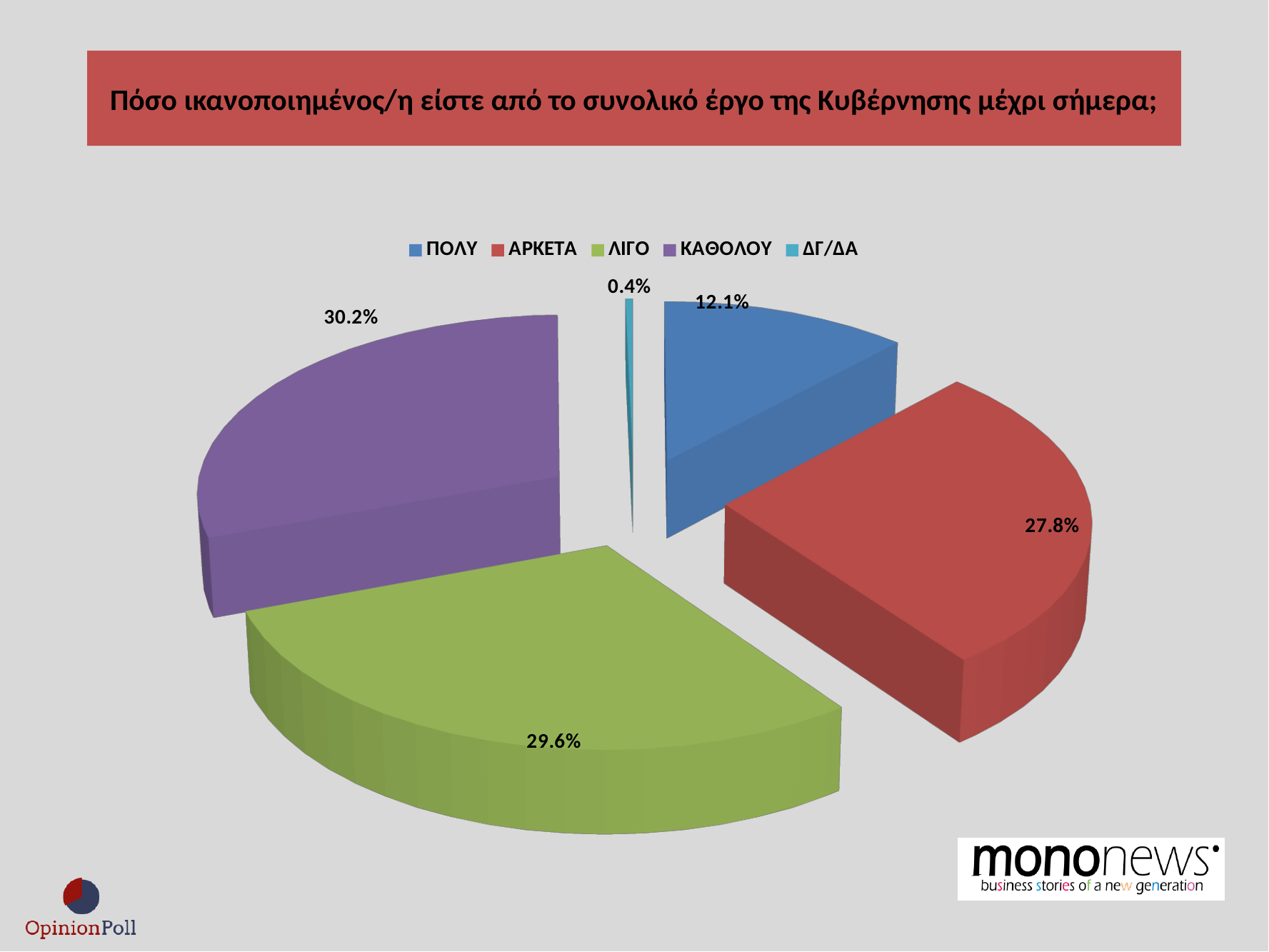
Which category has the largest share of the pie? ΚΑΘΟΛΟΥ How many categories does the legend list? 5 Which is larger, the share for ΑΡΚΕΤΑ or the share for ΠΟΛΥ? ΑΡΚΕΤΑ What percentage is shown for ΔΓ/ΔΑ? 0.4% Which category has the smallest share of the pie? ΔΓ/ΔΑ What is the difference in percentage points between ΚΑΘΟΛΟΥ and ΠΟΛΥ? 18.1 What type of chart is shown on the slide? Pie chart What percentage is shown for ΚΑΘΟΛΟΥ? 30.2% What colour is the slice for ΛΙΓΟ? Green What percentage is shown for ΑΡΚΕΤΑ? 27.8% What percentage is shown for ΛΙΓΟ? 29.6% What percentage is shown for ΠΟΛΥ? 12.1%